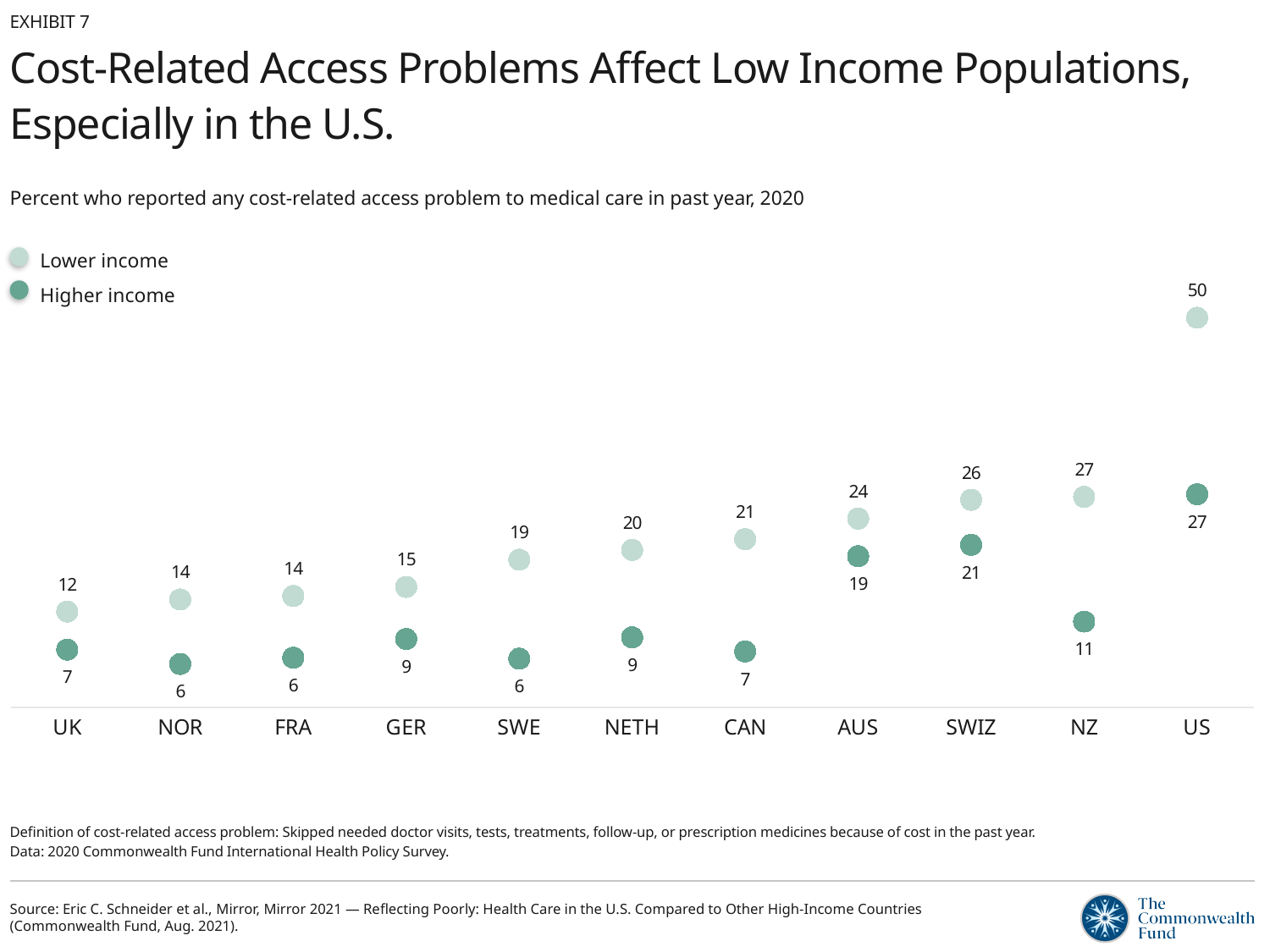
Do the Lower income values rise or fall from UK to US along the x axis? Rise What is the Lower income value for the US? 50 What is the Lower income value for SWE? 19 Which country has the lowest Lower income value? UK What kind of chart is this? Dot plot What is the Higher income value for NZ? 11 What is the difference between the Lower income and Higher income values for the US? 23 What is the difference between the Lower income and Higher income values for AUS? 5 How many countries are shown on the x axis? 11 Which is larger, the Higher income value for SWIZ or the Higher income value for NZ? SWIZ Which country has the highest Lower income value? US How many series does the legend list? 2